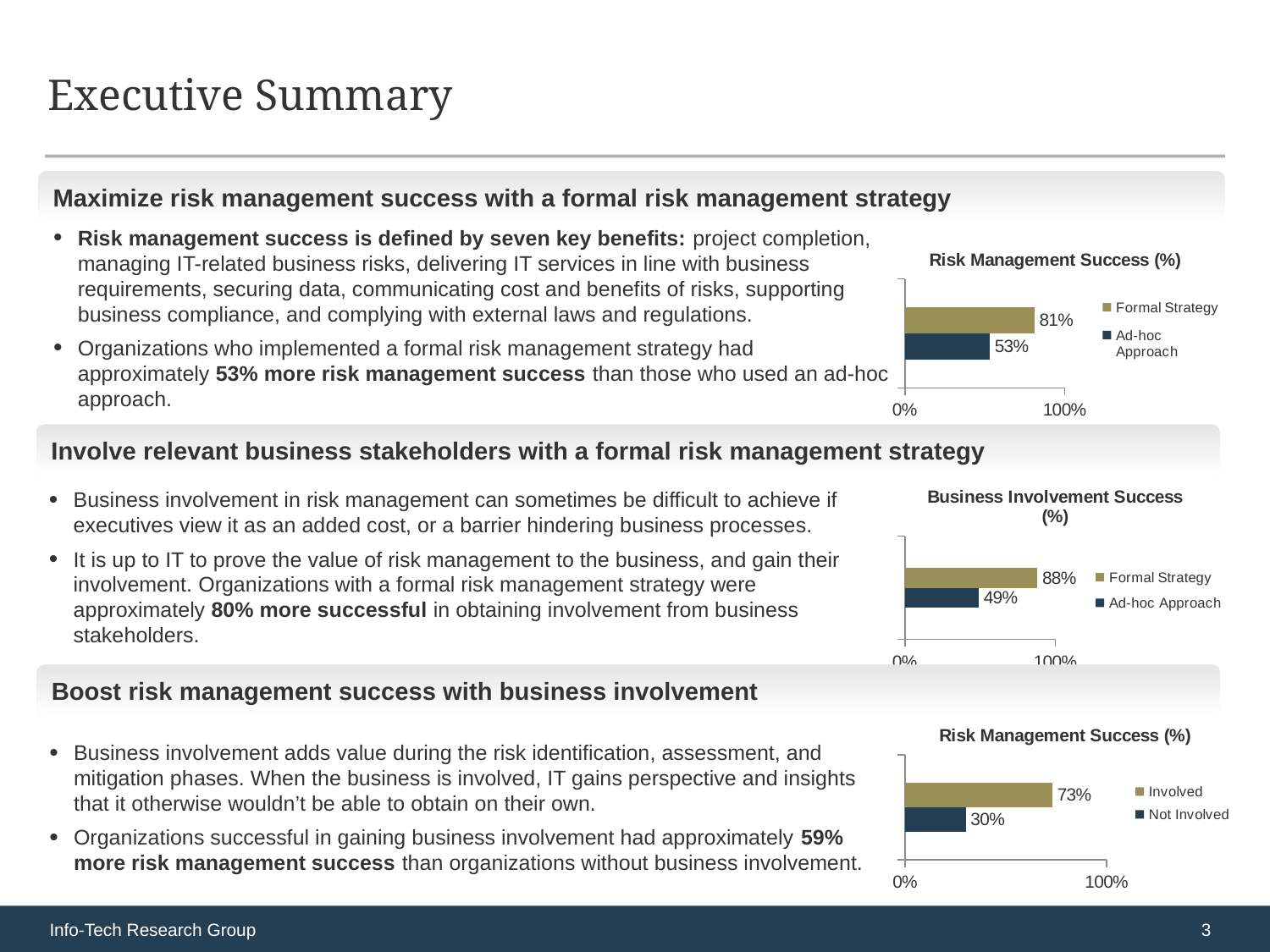
In the bottom chart titled 'Risk Management Success (%)', what is the value for Involved? 73% In the top chart titled 'Risk Management Success (%)', what is the value for Ad-hoc Approach? 53% In the top chart titled 'Risk Management Success (%)', what is the value for Formal Strategy? 81% In the 'Business Involvement Success (%)' chart, which series has the higher value? Formal Strategy In the bottom chart titled 'Risk Management Success (%)', which series has the lower value? Not Involved In the bottom chart titled 'Risk Management Success (%)', what is the difference between the Involved and Not Involved values? 43% In the 'Business Involvement Success (%)' chart, what is the value for Ad-hoc Approach? 49% In the 'Business Involvement Success (%)' chart, what is the value for Formal Strategy? 88% In the bottom chart titled 'Risk Management Success (%)', what is the value for Not Involved? 30% How many series does the legend of the 'Business Involvement Success (%)' chart list? 2 What kind of chart is the top 'Risk Management Success (%)' chart? Bar chart In the top chart titled 'Risk Management Success (%)', what is the difference between the Formal Strategy and Ad-hoc Approach values? 28%